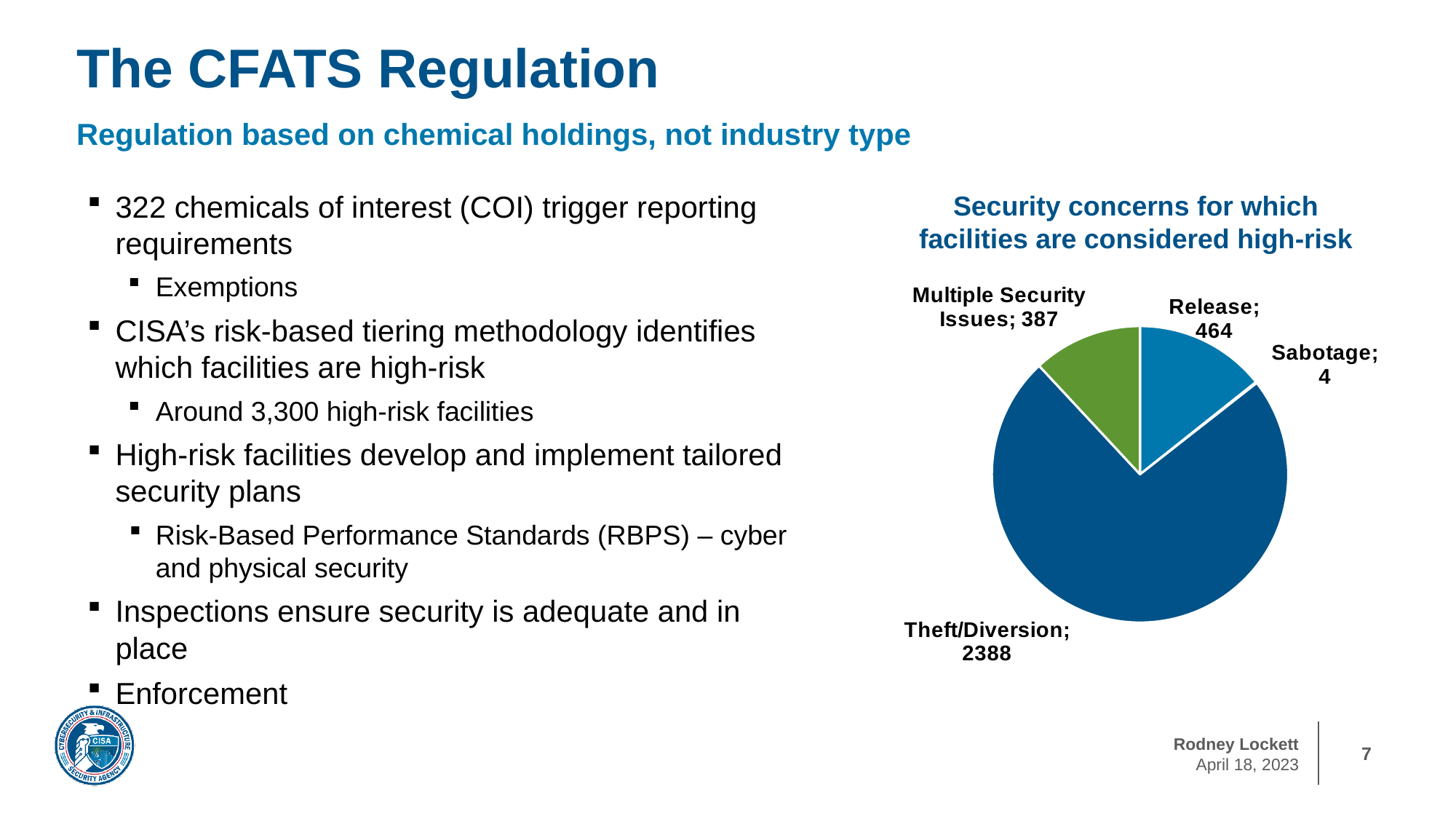
What kind of chart is shown on the slide? Pie chart Which security concern has the largest slice of the pie chart? Theft/Diversion What is the value for Release in the pie chart? 464 What is the difference between the Theft/Diversion value and the Release value? 1924 What is the value for Multiple Security Issues in the pie chart? 387 How many categories are shown in the pie chart? 4 What is the value for Sabotage in the pie chart? 4 What is the title of the chart on the slide? Security concerns for which facilities are considered high-risk Which security concern has the smallest slice of the pie chart? Sabotage What is the value for Theft/Diversion in the pie chart? 2388 Which is larger, Release or Multiple Security Issues? Release What is the difference between the Release value and the Multiple Security Issues value? 77